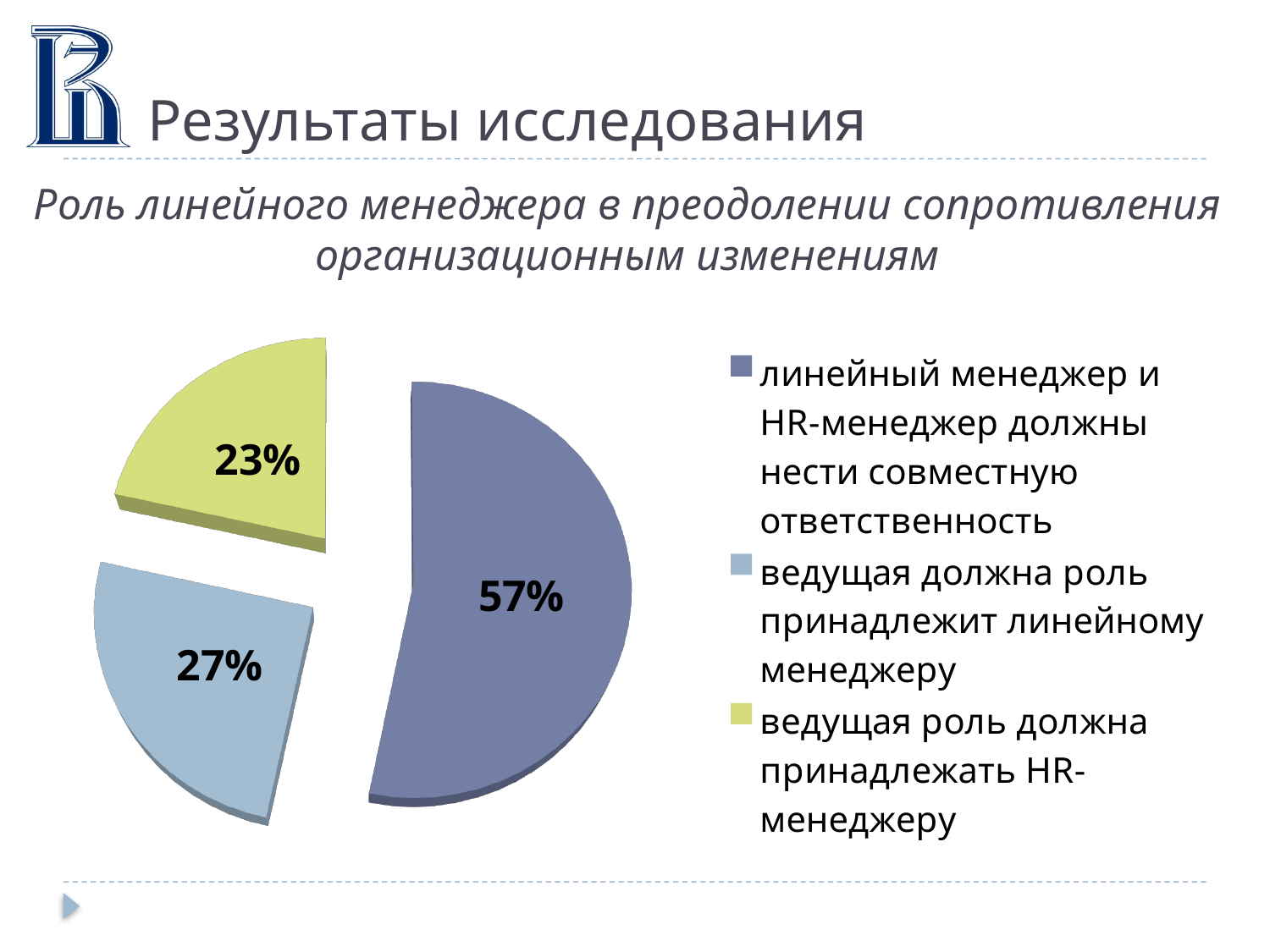
What percentage is shown for the option that the leading role should belong to the HR manager (ведущая роль должна принадлежать HR-менеджеру)? 23% What is the subtitle of the chart on the slide? Роль линейного менеджера в преодолении сопротивления организационным изменениям How many slices does the pie chart have? 3 What is the difference in percentage points between the 57% slice and the 27% slice? 30 Which is larger: the slice for the line manager having the leading role or the slice for the HR manager having the leading role? the line manager slice (27%) Which option has the smallest slice of the pie? ведущая роль должна принадлежать HR-менеджеру What kind of chart is shown on the slide? pie chart What is the difference in percentage points between the slice for the line manager leading (27%) and the slice for the HR manager leading (23%)? 4 What colour is the slice labelled 23%? yellow-green What share of the pie is labelled for the option that the line manager and HR manager should share responsibility (линейный менеджер и HR-менеджер должны нести совместную ответственность)? 57% Which option has the largest slice of the pie? линейный менеджер и HR-менеджер должны нести совместную ответственность What percentage is shown for the option that the leading role should belong to the line manager (ведущая роль принадлежит линейному менеджеру)? 27%